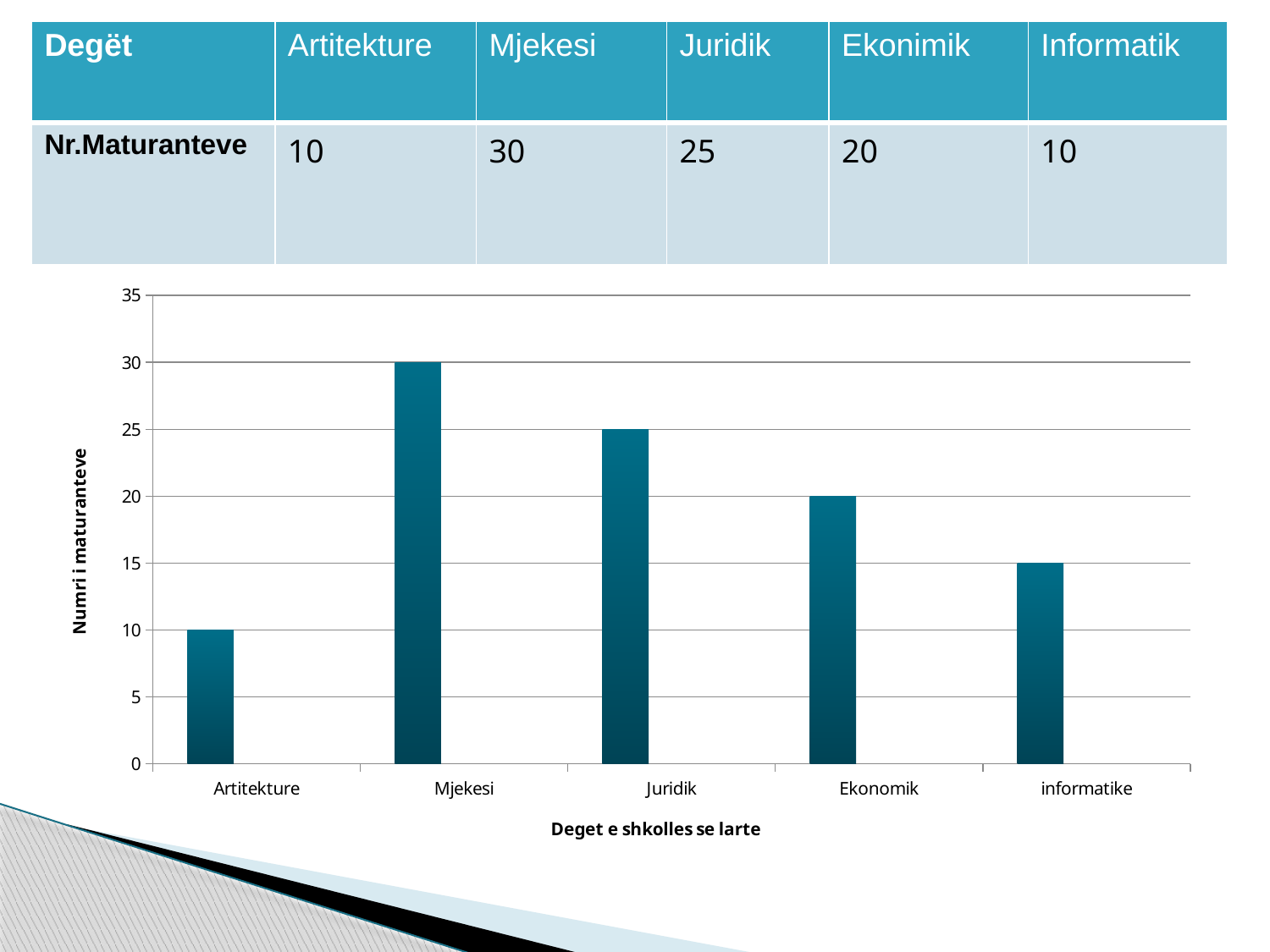
What is the value of the bar for Mjekesi? 30 What is the value of the bar for informatike in the chart? 15 What is the title of the y axis of the chart? Numri i maturanteve What is the title of the x axis of the chart? Deget e shkolles se larte What kind of chart is shown on the slide? bar chart How many categories are plotted on the x axis of the chart? 5 What is the value of the bar for Ekonomik? 20 Which category has the lowest bar in the chart? Artitekture Which is larger, the bar for Juridik or the bar for Ekonomik? Juridik Which category has the highest bar in the chart? Mjekesi What is the difference between the bars for Mjekesi and Artitekture? 20 What is the value of the bar for Juridik? 25